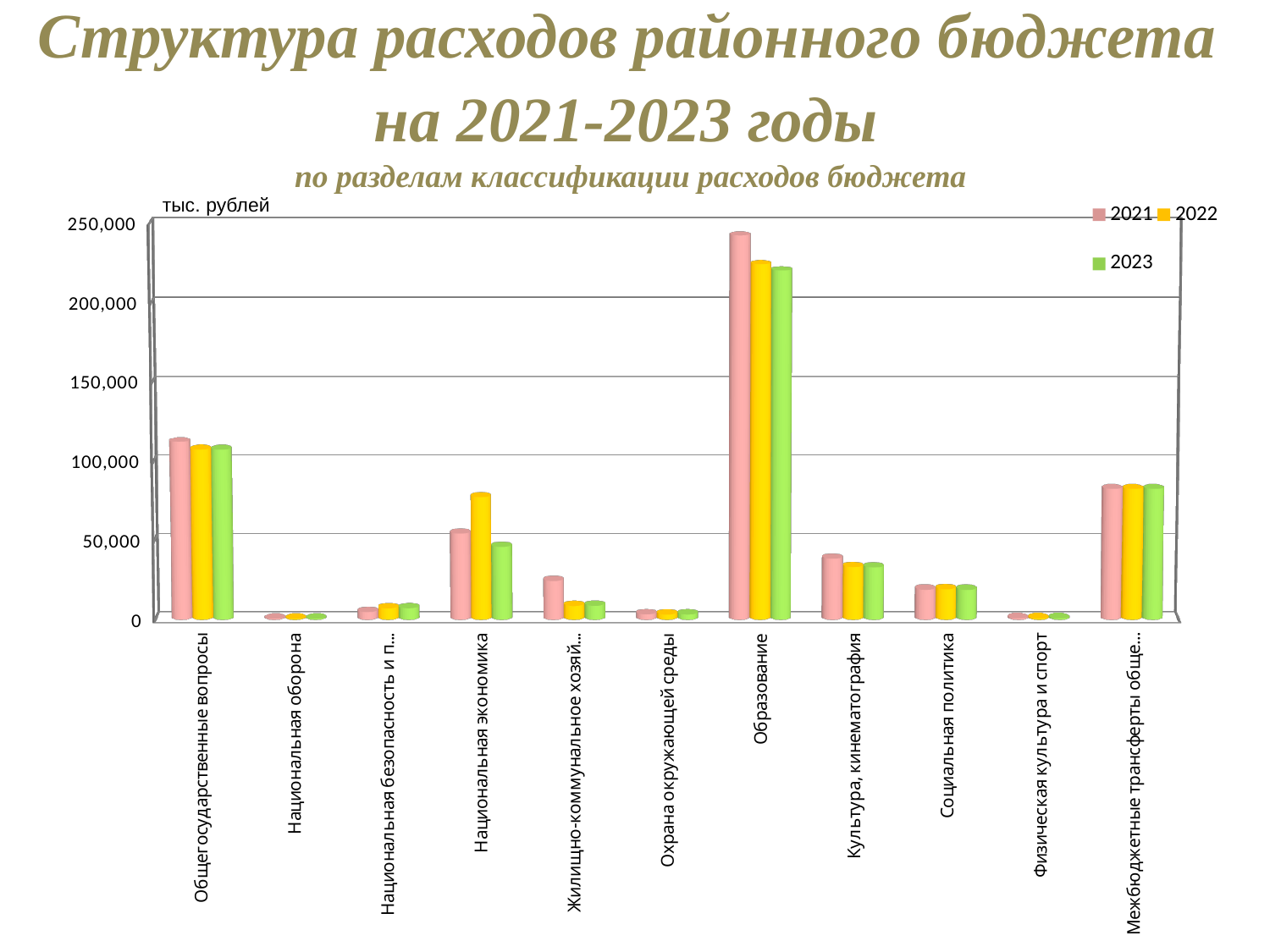
How many series does the legend list? 3 What unit is indicated at the top of the vertical axis? тыс. рублей Is the 2021 value for Культура, кинематография greater or less than 50,000? less For Национальная экономика, which year has the larger value, 2021 or 2022? 2022 What kind of chart is shown on the slide? bar chart Do the values for Образование rise or fall from 2021 to 2023? fall Is the 2021 value for Образование greater or less than 200,000? greater For Образование, which year has the larger value, 2021 or 2023? 2021 Is the 2021 value for Общегосударственные вопросы greater or less than 100,000? greater How many expenditure categories are shown along the x axis? 11 Which category has the highest value for 2021? Образование